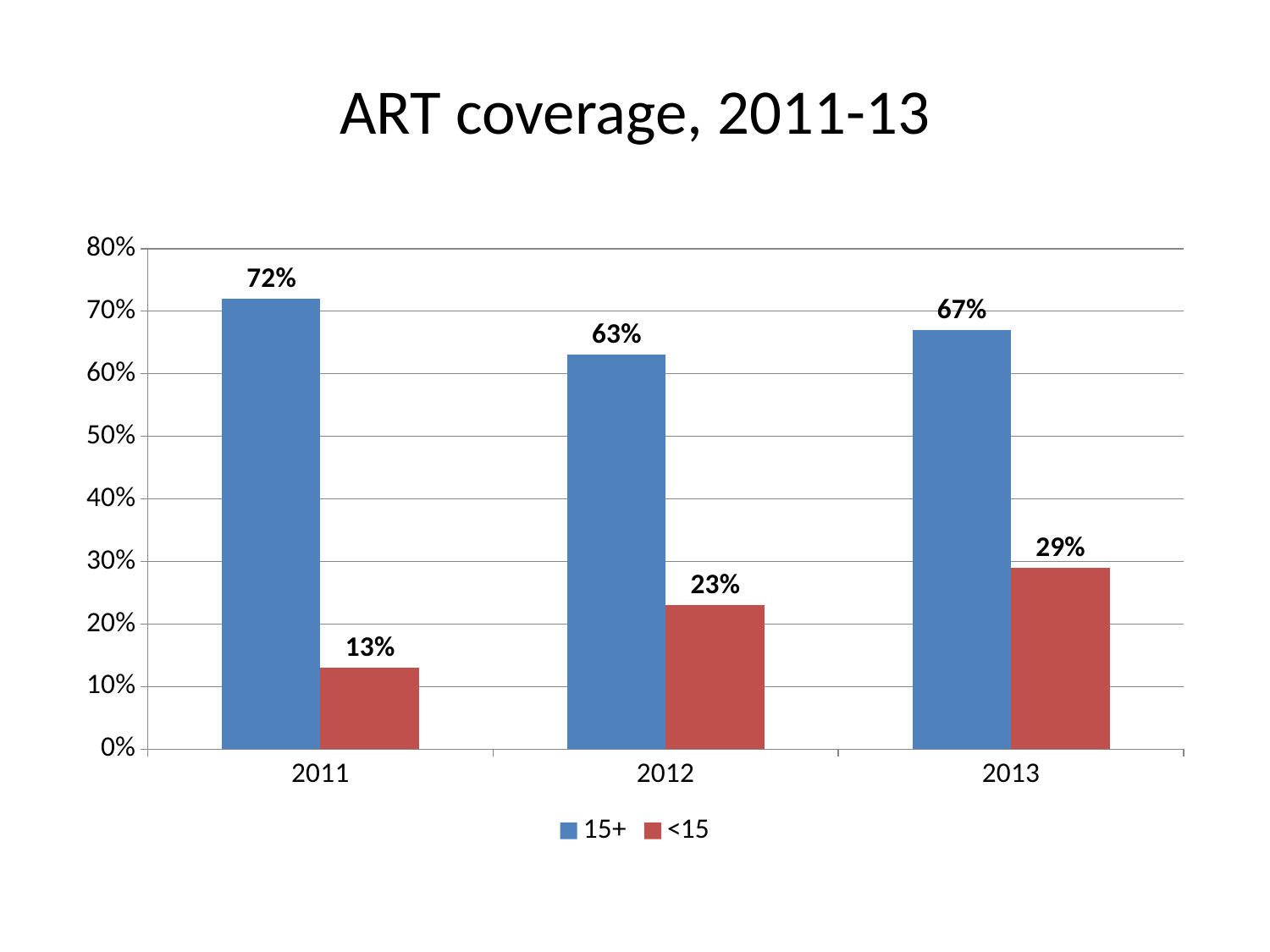
What is the ART coverage for the 15+ group in 2011? 72% In which year is the <15 ART coverage lowest? 2011 In which year is the 15+ ART coverage highest? 2011 What kind of chart is shown on the slide? Bar chart By how much did the <15 ART coverage increase from 2011 to 2013? 16% Does the <15 ART coverage rise or fall from 2011 to 2013? Rise How many series does the legend list? 2 What is the difference between the 15+ and <15 ART coverage in 2013? 38% What is the ART coverage for the <15 group in 2013? 29% Which is larger, the 15+ coverage in 2012 or the 15+ coverage in 2013? 2013 How many years are shown on the x axis? 3 What is the ART coverage for the <15 group in 2012? 23%